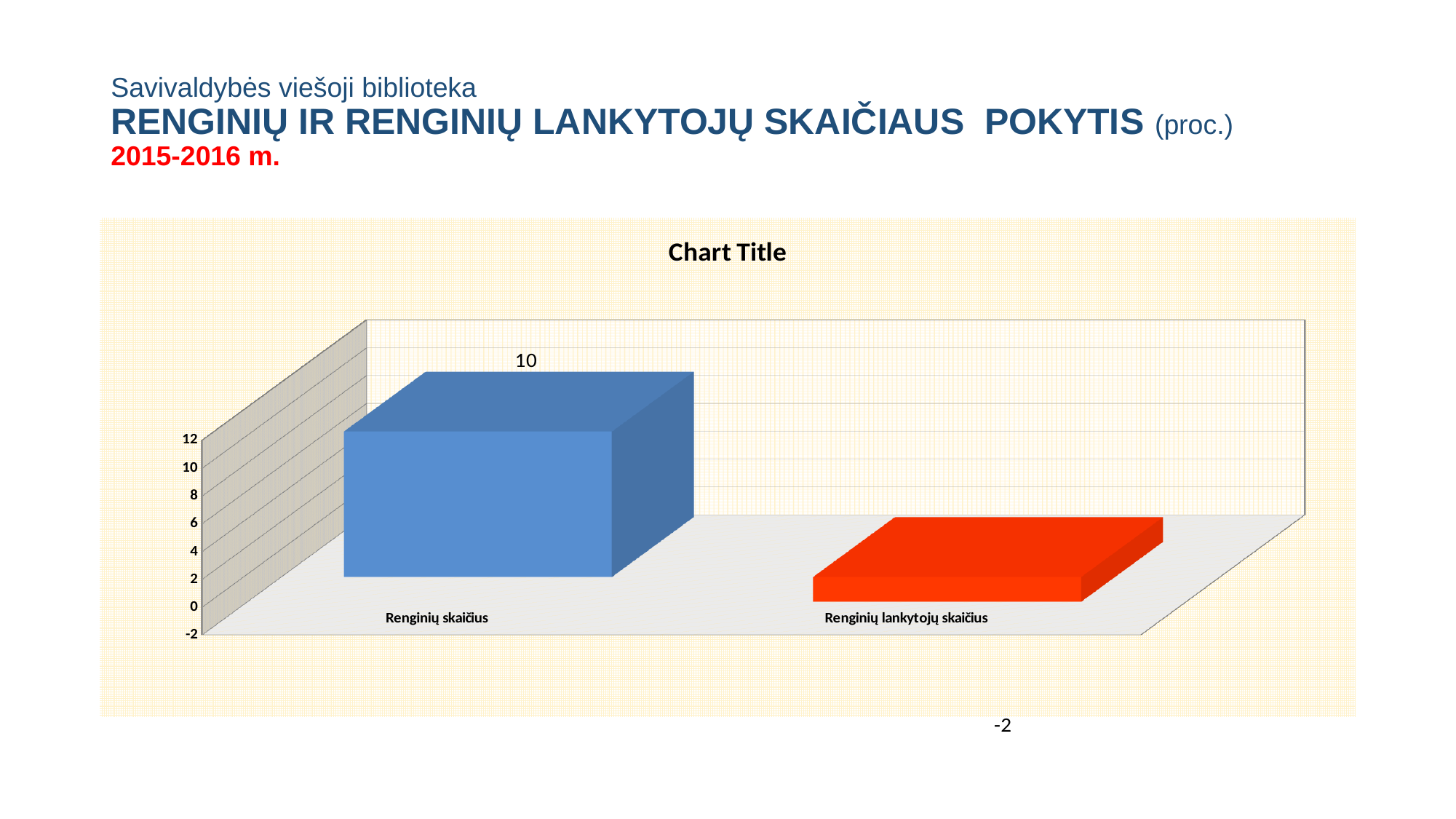
What is the value for Renginių skaičius? 10 Which category has the highest value? Renginių skaičius What colour is the bar for Renginių lankytojų skaičius? red What is the title shown above the chart? Chart Title What is the difference between the values for Renginių skaičius and Renginių lankytojų skaičius? 12 What kind of chart is shown on the slide? bar chart What is the value for Renginių lankytojų skaičius? -2 Is the value for Renginių skaičius greater or less than 6? greater Is the value for Renginių lankytojų skaičius greater or less than 0? less How many categories are shown in the chart? 2 Which is larger, the value for Renginių skaičius or the value for Renginių lankytojų skaičius? Renginių skaičius Which category has the lowest value? Renginių lankytojų skaičius